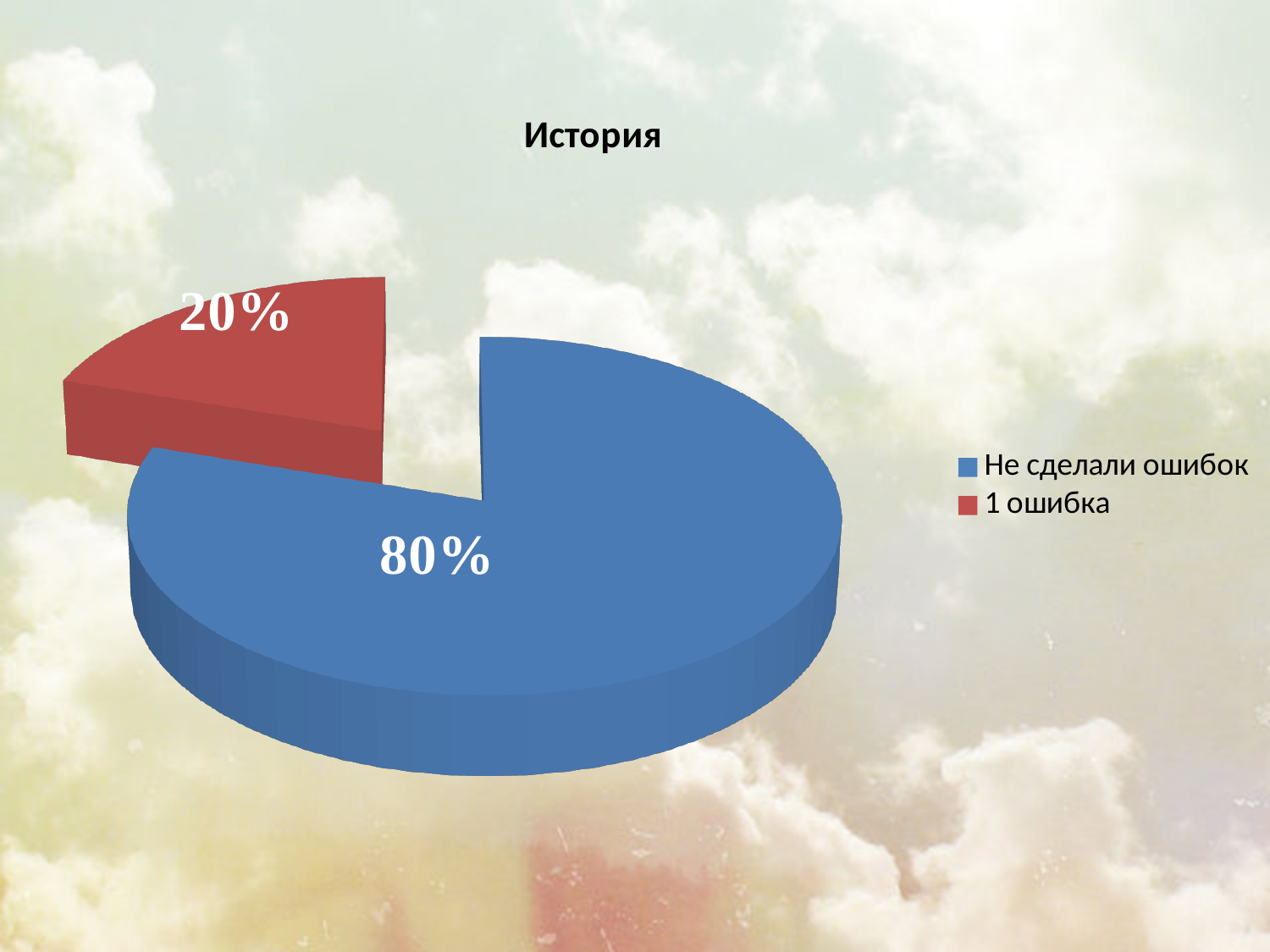
What is the title of the chart? История What colour is the slice for "1 ошибка"? red What share of the pie does "1 ошибка" take? 20% What share of the pie does "Не сделали ошибок" take? 80% Which category has the smallest slice of the pie? 1 ошибка How many categories does the pie chart show? 2 What is the difference in percentage points between "Не сделали ошибок" and "1 ошибка"? 60% Which category has the largest slice of the pie? Не сделали ошибок Which is larger: the share for "Не сделали ошибок" or the share for "1 ошибка"? Не сделали ошибок How many entries does the legend list? 2 What kind of chart is shown on the slide? pie chart